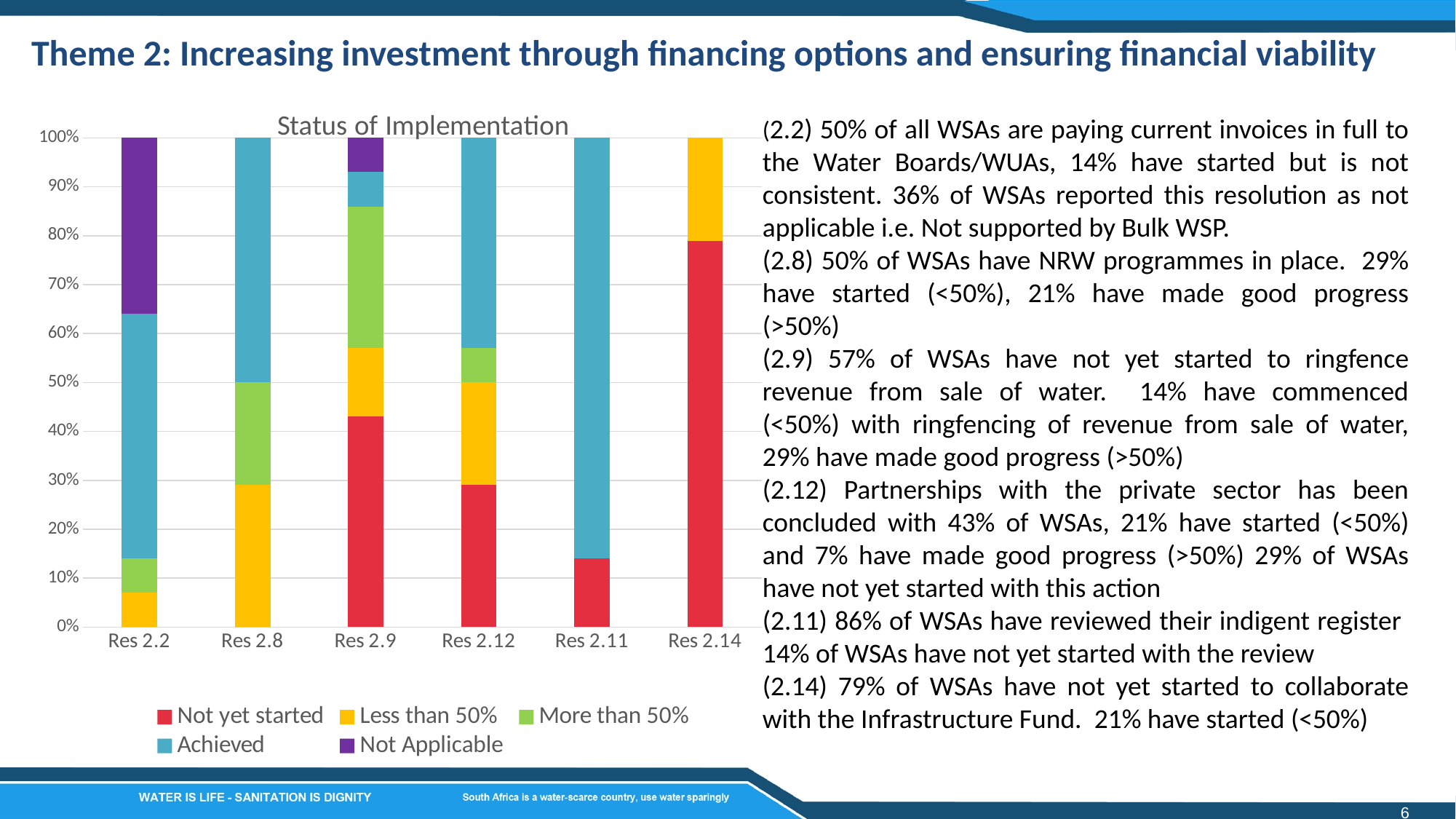
Which resolution has the largest 'Achieved' segment in the chart? Res 2.11 What is the title of the chart? Status of Implementation Is the 'Achieved' value for Res 2.11 greater or less than 80%? greater Is the 'Not yet started' value for Res 2.11 greater or less than 20%? less Which colour represents 'Not yet started' in the chart? Red How many series does the chart legend list? 5 How many resolutions (categories) are shown on the x axis of the chart? 6 Which resolution has the largest 'Not yet started' segment in the chart? Res 2.14 Is the 'Not yet started' value for Res 2.14 greater or less than 70%? greater Which is larger: the 'Not yet started' segment for Res 2.9 or for Res 2.12? Res 2.9 What type of chart is shown on the slide? Stacked bar chart